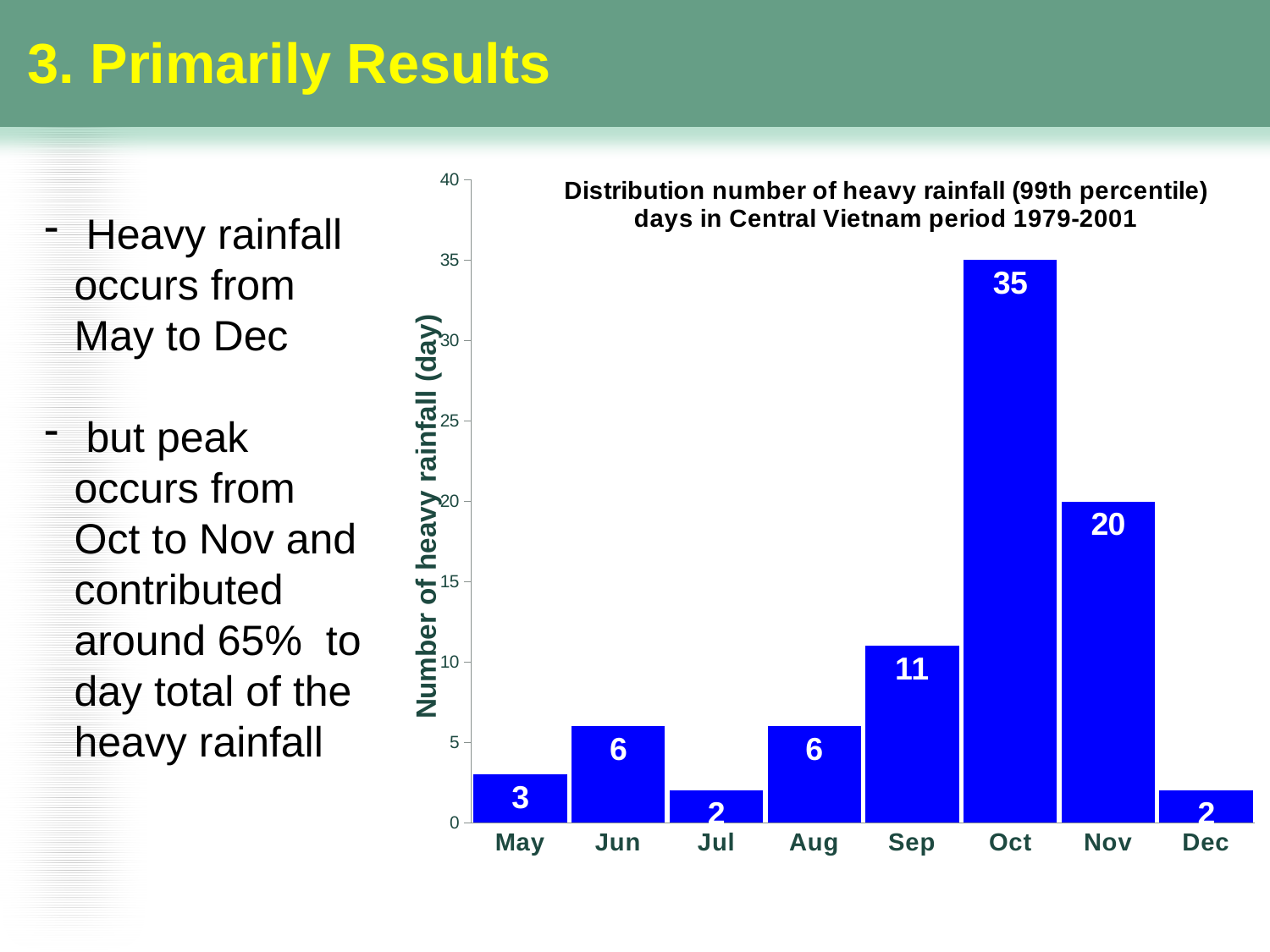
What is the number of heavy rainfall days for May? 3 Which month has more heavy rainfall days, Sep or Nov? Nov What is the label of the y axis of the chart? Number of heavy rainfall (day) What period does the chart title say the data covers? 1979-2001 Is the value for Nov greater or less than 15? greater Which month has the highest number of heavy rainfall days? Oct How many months are shown on the x axis of the chart? 8 What kind of chart is shown on the slide? bar chart What is the number of heavy rainfall days for Oct? 35 What is the difference in heavy rainfall days between Oct and Nov? 15 Do the values rise or fall from Sep to Oct? rise What is the number of heavy rainfall days for Sep? 11